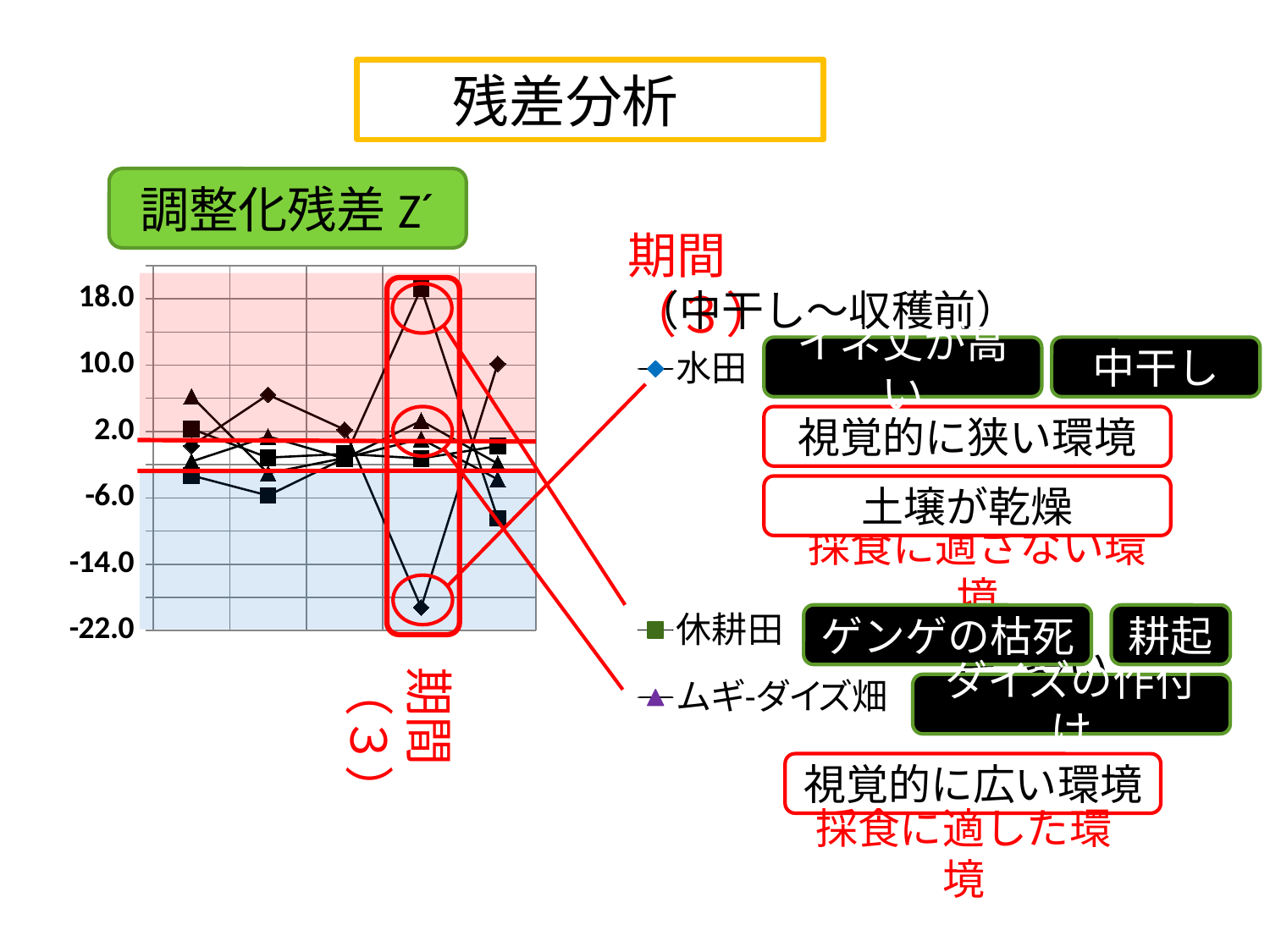
What kind of chart is shown on the slide? line chart At period (3), which is larger: the value for ムギ-ダイズ畑 or the value for 水田? ムギ-ダイズ畑 At period (3), which is larger: the value for 休耕田 or the value for ムギ-ダイズ畑? 休耕田 Which series has the highest value at the circled period (3) position? 休耕田 How many data points does each series have along the x axis? 5 How many series does the chart legend list? 3 What is the title shown above the chart? 調整化残差 Z′ What is the highest tick value shown on the y axis? 18.0 What are the three series named in the chart legend? 水田, 休耕田, ムギ-ダイズ畑 Is the value for 水田 at period (3) greater or less than -14.0? less Which series has the lowest value at the circled period (3) position? 水田 Is the value for 休耕田 at period (3) greater or less than 10.0? greater